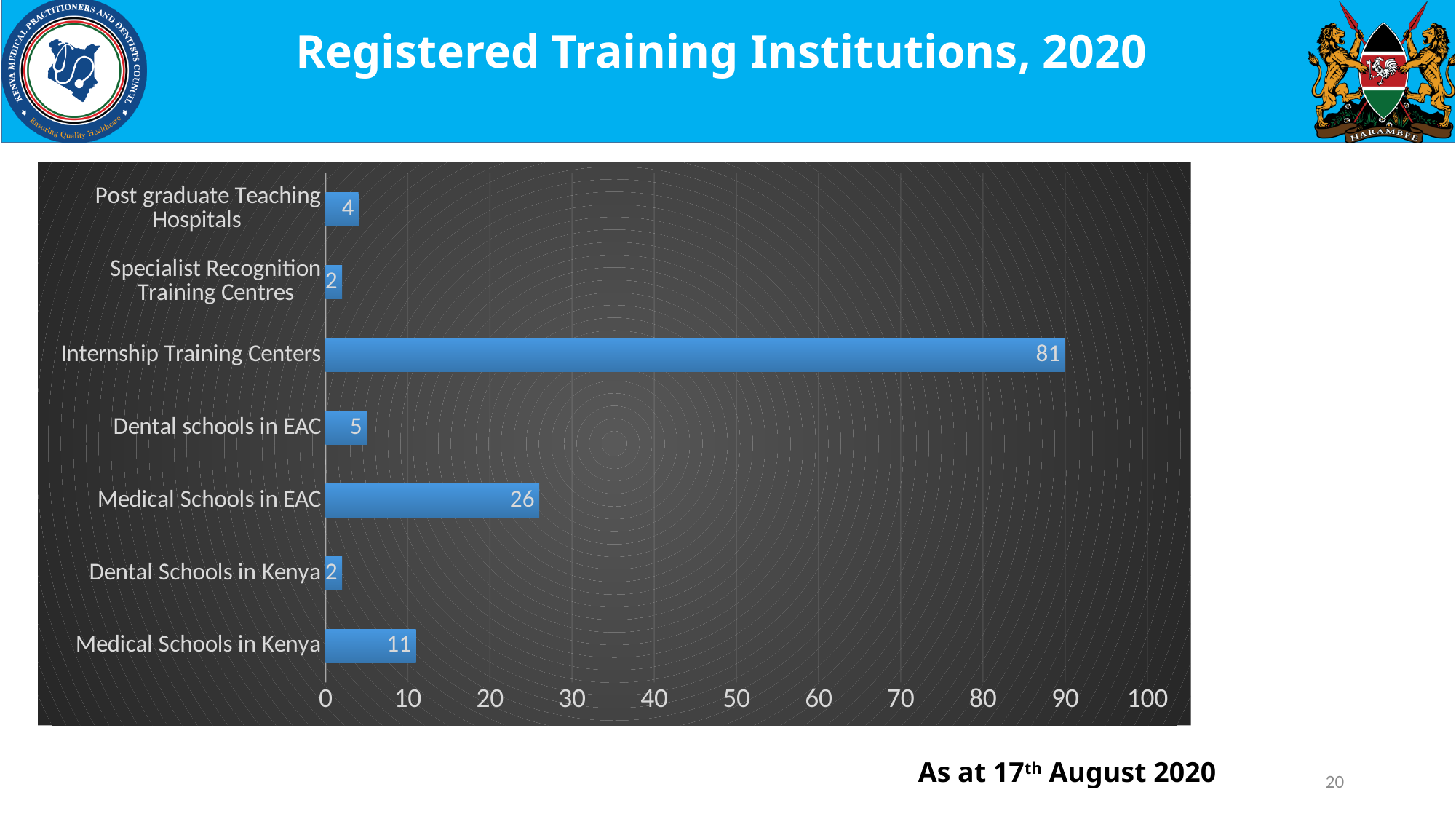
Which is larger, Dental schools in EAC or Post graduate Teaching Hospitals? Dental schools in EAC What is the value for Internship Training Centers? 81 How many categories are shown in the chart? 7 What is the title of the slide? Registered Training Institutions, 2020 What is the difference between Internship Training Centers and Medical Schools in EAC? 55 What is the difference between Medical Schools in EAC and Medical Schools in Kenya? 15 Is the value for Internship Training Centers greater or less than 80? greater What is the value for Medical Schools in EAC? 26 What is the value for Post graduate Teaching Hospitals? 4 What is the value for Medical Schools in Kenya? 11 What kind of chart is shown on the slide? bar chart Which category has the highest value? Internship Training Centers